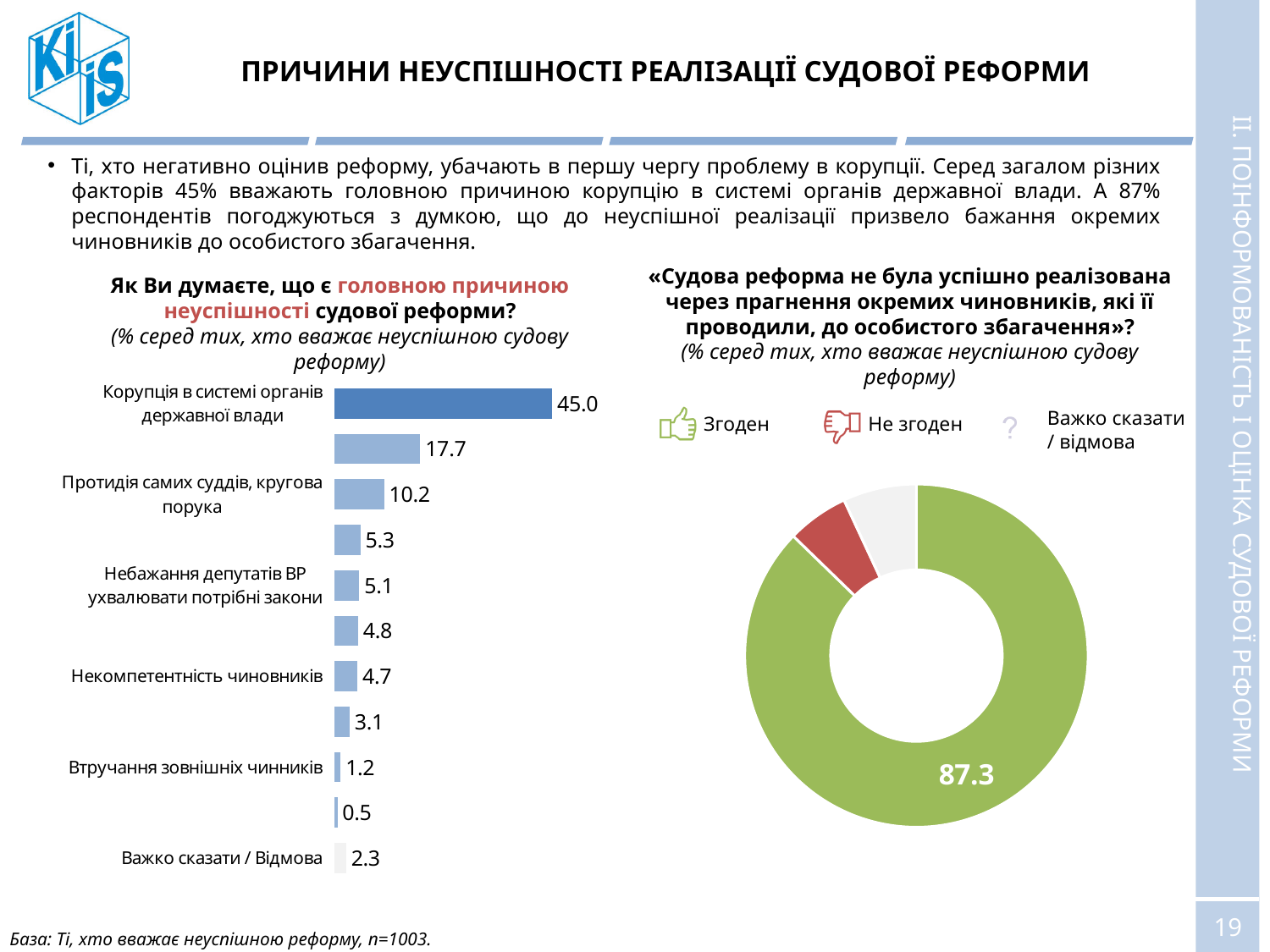
How many bars are plotted in the left bar chart? 11 How many entries does the legend of the right donut chart list? 3 In the left bar chart, what is the value of the shortest bar? 0.5 In the right donut chart, what share is shown for "Згоден"? 87.3 In the left bar chart, what is the value for "Важко сказати / Відмова"? 2.3 In the left bar chart, which category has the highest value? Корупція в системі органів державної влади In the left bar chart, what is the difference between the values for "Корупція в системі органів державної влади" and "Протидія самих суддів, кругова порука"? 34.8 In the left bar chart, what is the value for "Некомпетентність чиновників"? 4.7 In the left bar chart, what is the value for "Корупція в системі органів державної влади"? 45.0 What kind of chart is shown on the left side of the slide? Bar chart In the left bar chart, what is the value for "Протидія самих суддів, кругова порука"? 10.2 In the left bar chart, which is larger: "Небажання депутатів ВР ухвалювати потрібні закони" or "Втручання зовнішніх чинників"? Небажання депутатів ВР ухвалювати потрібні закони